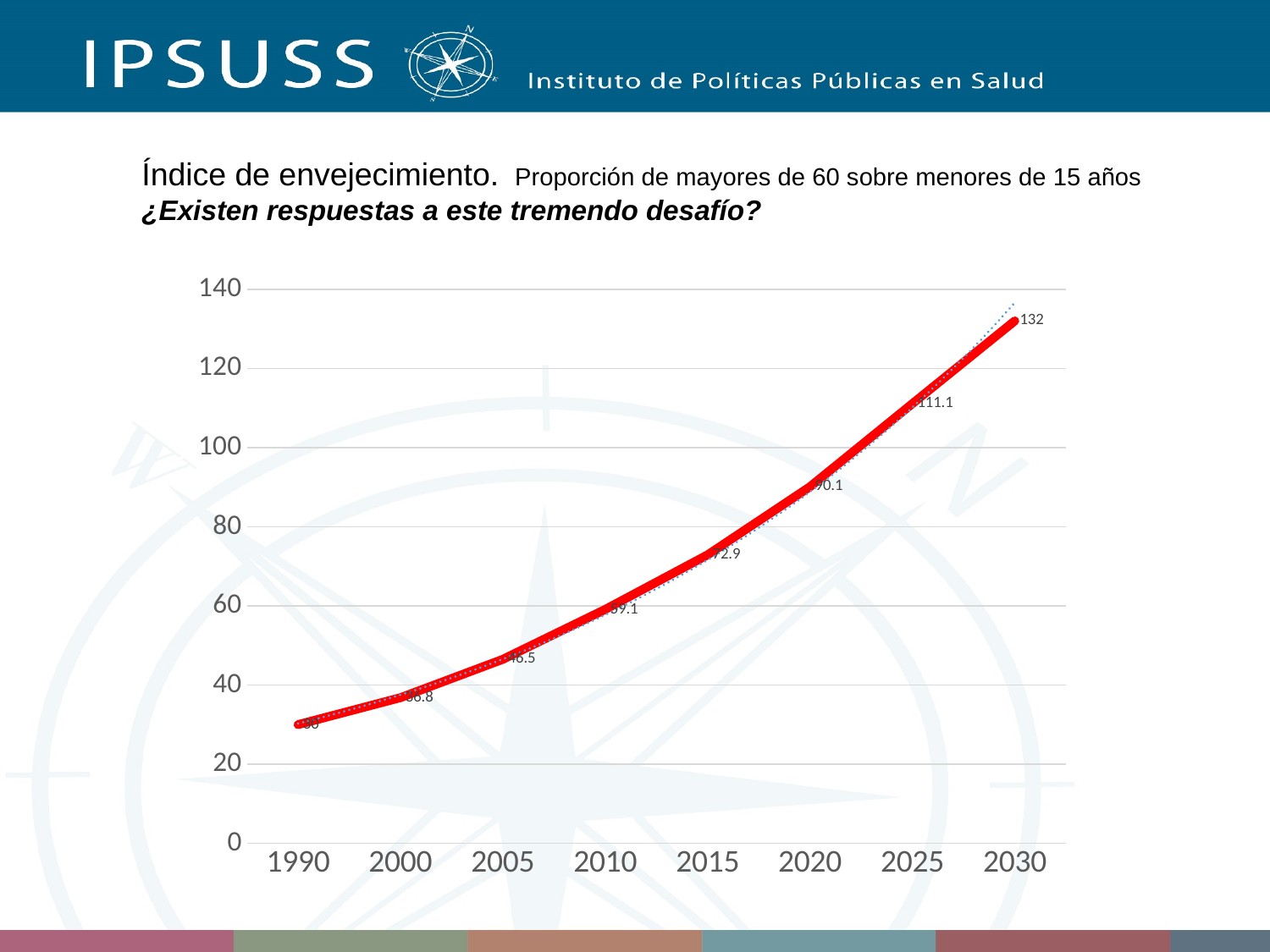
What is the value of the ageing index for 2015? 72.9 What is the value of the ageing index for 2025? 111.1 How many years are plotted on the x axis? 8 Which year has the highest value on the chart? 2030 What kind of chart is shown on the slide? line chart What is the value of the ageing index for 2030? 132 What is the value of the ageing index for 2005? 46.5 What is the difference between the values for 2030 and 2025? 20.9 Which year has the lowest value on the chart? 1990 What is the value of the ageing index for 2020? 90.1 Do the values rise or fall from 1990 to 2030? rise Is the value for 1990 greater or less than 40? less